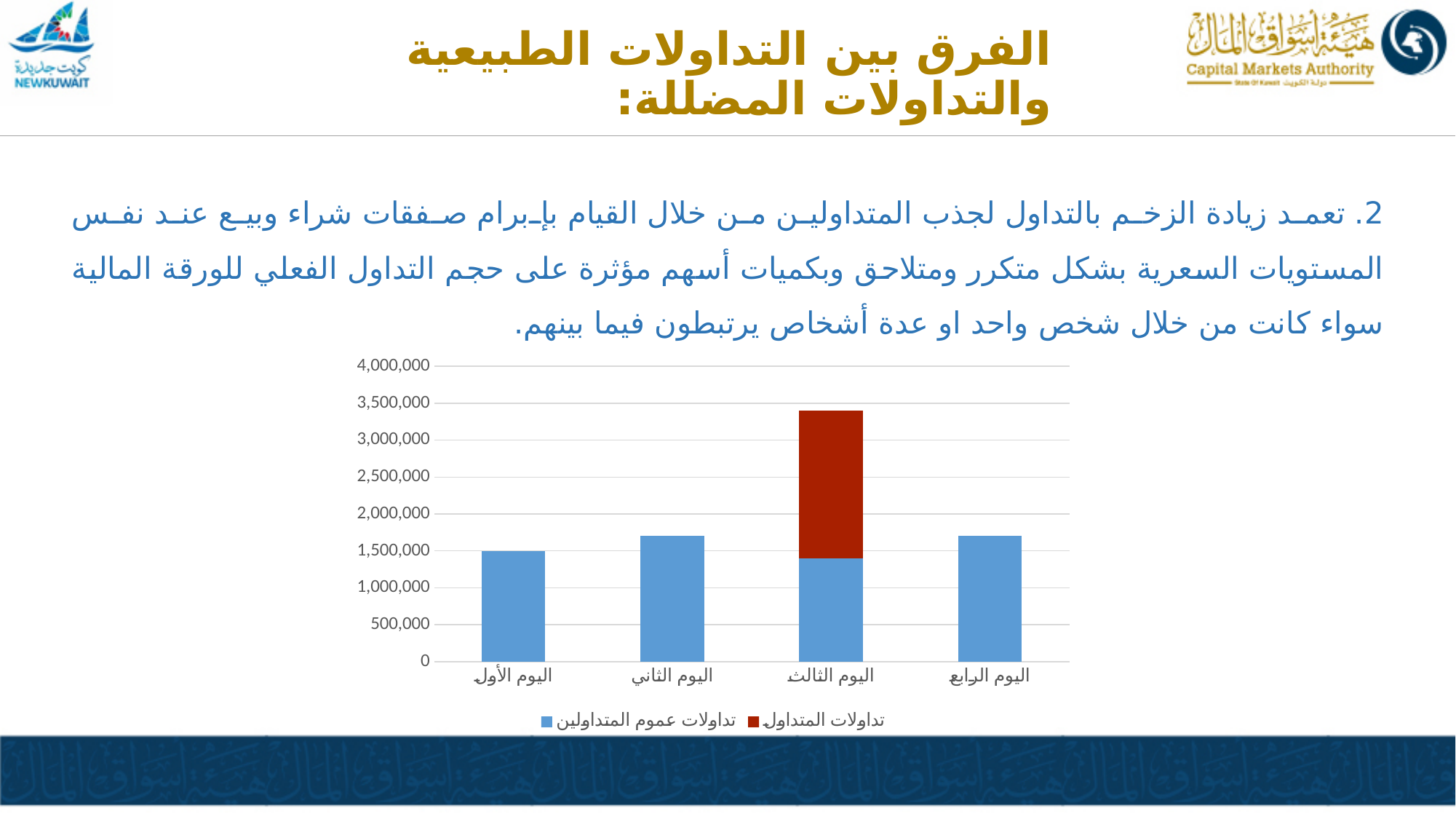
What colour represents the series تداولات عموم المتداولين in the chart? blue Is the total bar for اليوم الثالث greater or less than 3,000,000? greater Is the value for اليوم الرابع greater or less than 2,000,000? less How many categories (days) are shown on the x axis of the chart? 4 Which day has the shortest bar in the chart? اليوم الأول How many series does the chart legend list? 2 Is the value for اليوم الثاني greater or less than 1,500,000? greater Which day is the only one with a segment for the series تداولات المتداول? اليوم الثالث What kind of chart is shown on the slide? bar chart Which bar is taller, اليوم الثالث or اليوم الأول? اليوم الثالث Which day has the tallest bar in the chart? اليوم الثالث